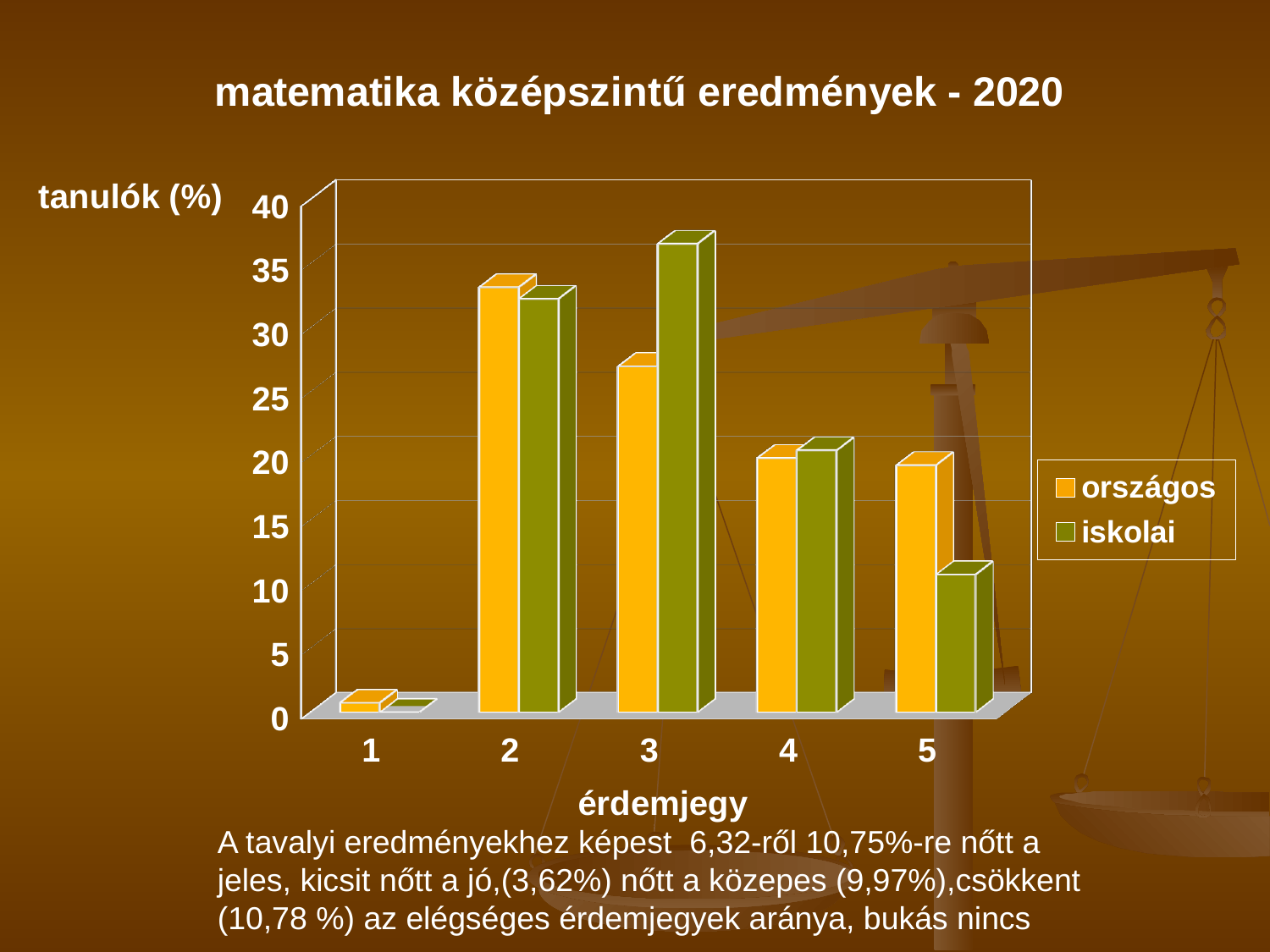
Is the iskolai value for érdemjegy 5 greater or less than 15? less What is the label of the y axis? tanulók (%) How many series does the legend list? 2 For érdemjegy 5, which series has the larger value, országos or iskolai? országos For which érdemjegy is the országos value the lowest? 1 For which érdemjegy is the országos value the highest? 2 For érdemjegy 3, which series has the larger value, országos or iskolai? iskolai What kind of chart is shown on the slide? bar chart What are the two series named in the legend? országos, iskolai Is the iskolai value for érdemjegy 3 greater or less than 30? greater For which érdemjegy is the iskolai value the highest? 3 How many érdemjegy categories are shown on the x axis? 5